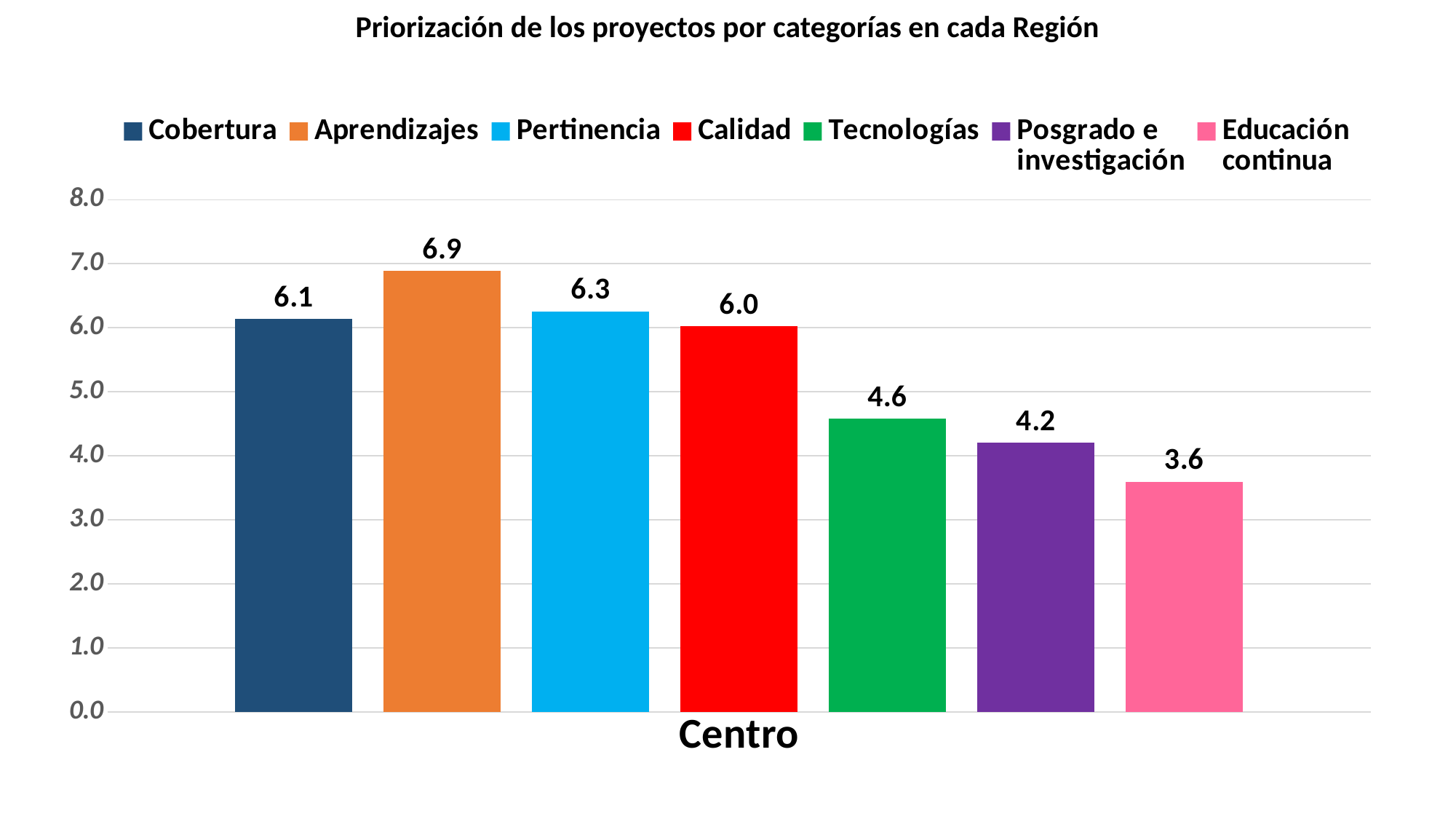
What is the title of the chart? Priorización de los proyectos por categorías en cada Región What is the value for Educación continua in the Centro region? 3.6 What is the difference between the values for Aprendizajes and Educación continua? 3.3 What is the difference between the values for Pertinencia and Posgrado e investigación? 2.1 Which is larger, the value for Calidad or the value for Tecnologías? Calidad What kind of chart is shown on the slide? Bar chart What is the value for Tecnologías? 4.6 What is the value for Aprendizajes in the Centro region? 6.9 Which category has the highest value? Aprendizajes Which category has the lowest value? Educación continua Is the value for Posgrado e investigación greater or less than 5.0? less How many series does the legend list? 7